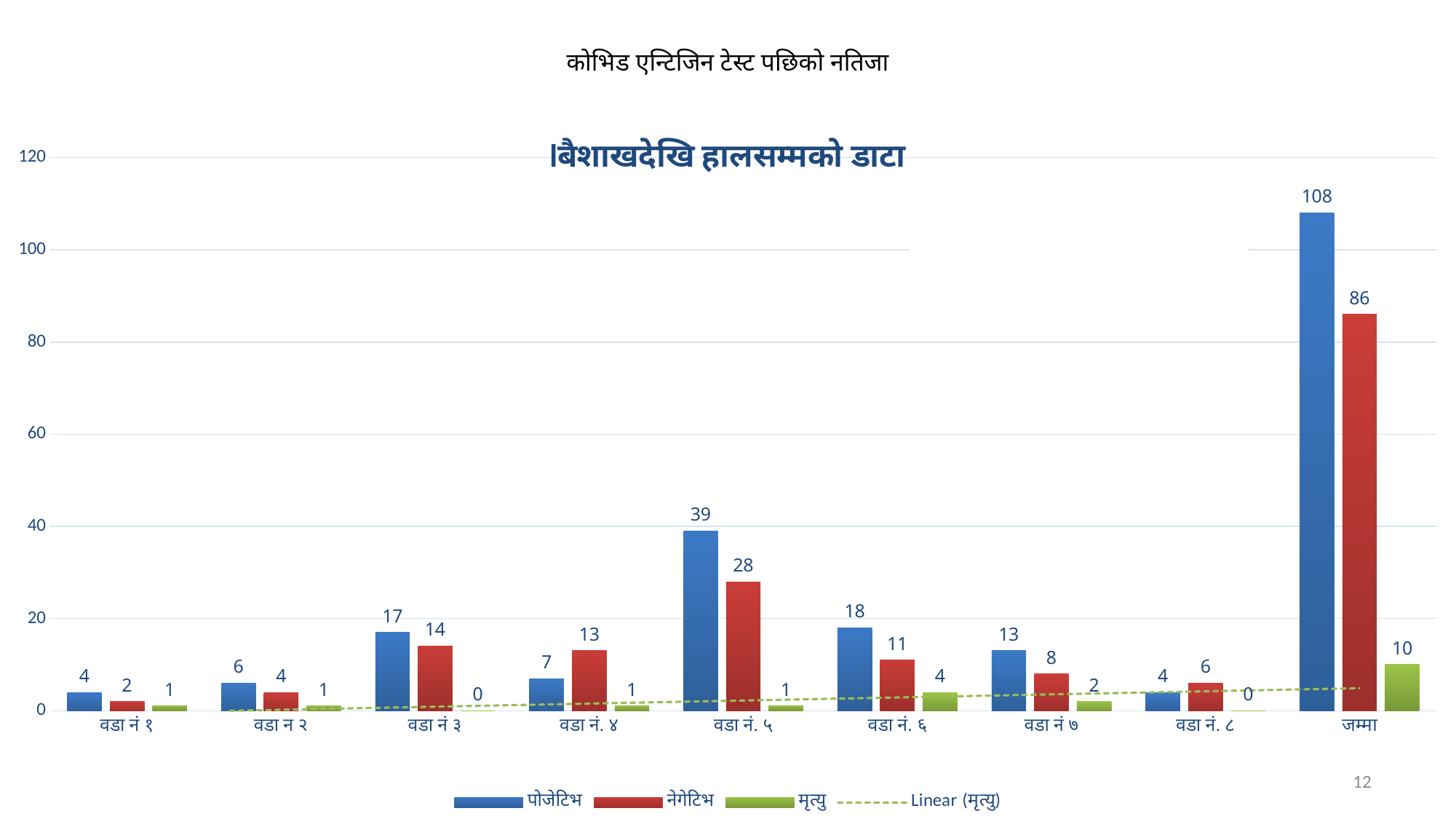
For वडा नं. ४, which is larger: पोजेटिभ or नेगेटिभ? नेगेटिभ What is the title of the chart? बैशाखदेखि हालसम्मको डाटा How many categories are shown on the x axis? 9 What kind of chart is shown on the slide? bar chart Is the पोजेटिभ value for जम्मा greater or less than 100? greater What is the मृत्यु value for वडा नं. ६? 4 What is the पोजेटिभ value for वडा नं. ५? 39 What is the difference between the पोजेटिभ and नेगेटिभ values for वडा नं. ५? 11 Excluding जम्मा, which ward has the highest पोजेटिभ value? वडा नं. ५ What is the नेगेटिभ value for जम्मा? 86 How many entries does the legend list? 4 Which category has the lowest नेगेटिभ value? वडा नं १